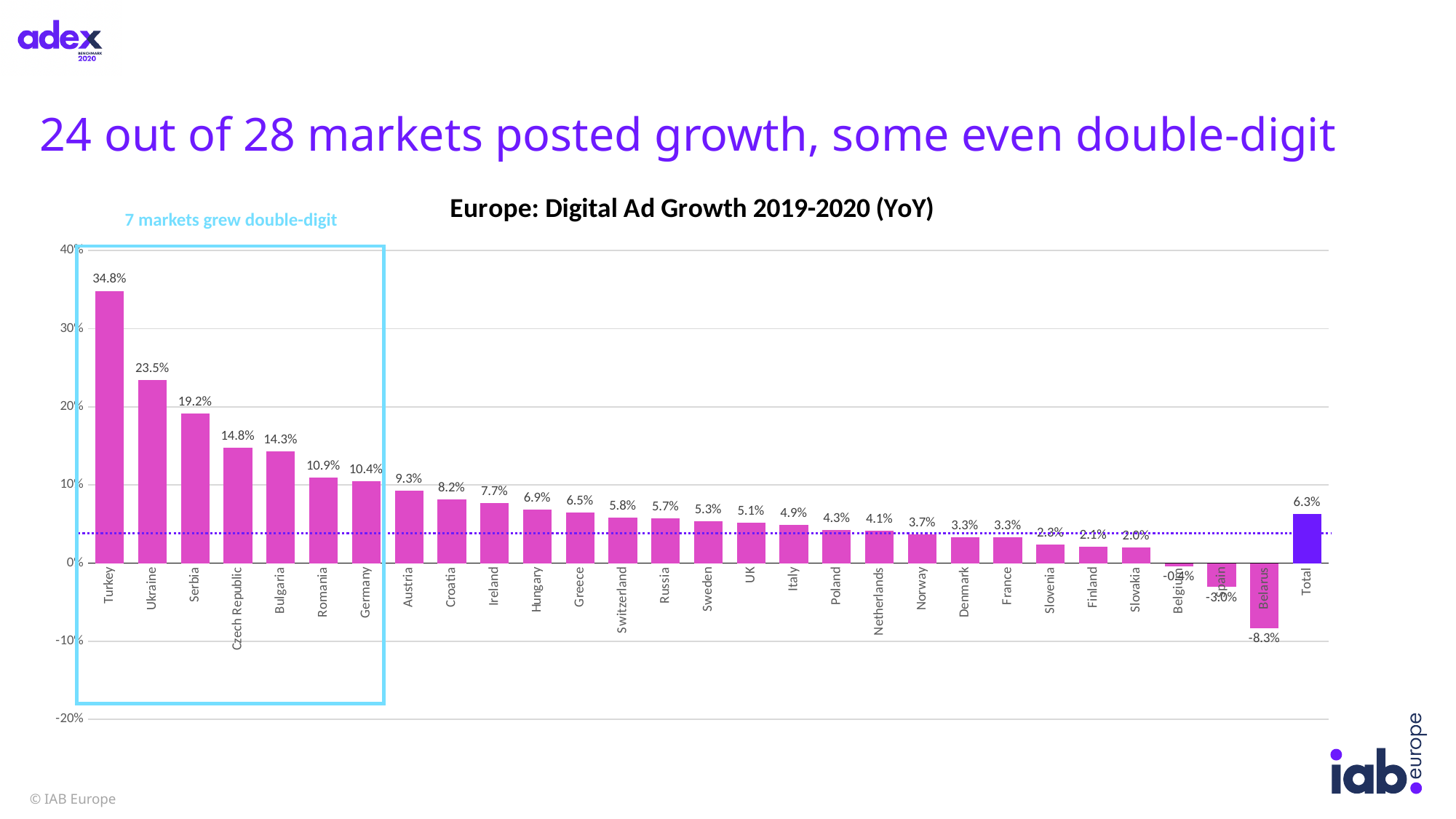
How many markets show negative growth? 3 Which market has the highest digital ad growth? Turkey What is the difference between the values for Turkey and Ukraine? 11.3% What is the title of the chart? Europe: Digital Ad Growth 2019-2020 (YoY) What is the value shown for the Total bar? 6.3% Is the value for Slovenia greater or less than 10%? less Which has the larger value, Austria or Croatia? Austria What is the value shown for Spain? -3.0% What kind of chart is shown on the slide? bar chart Which market has the lowest digital ad growth? Belarus What is the digital ad growth value shown for Turkey? 34.8% What is the value shown for Germany? 10.4%